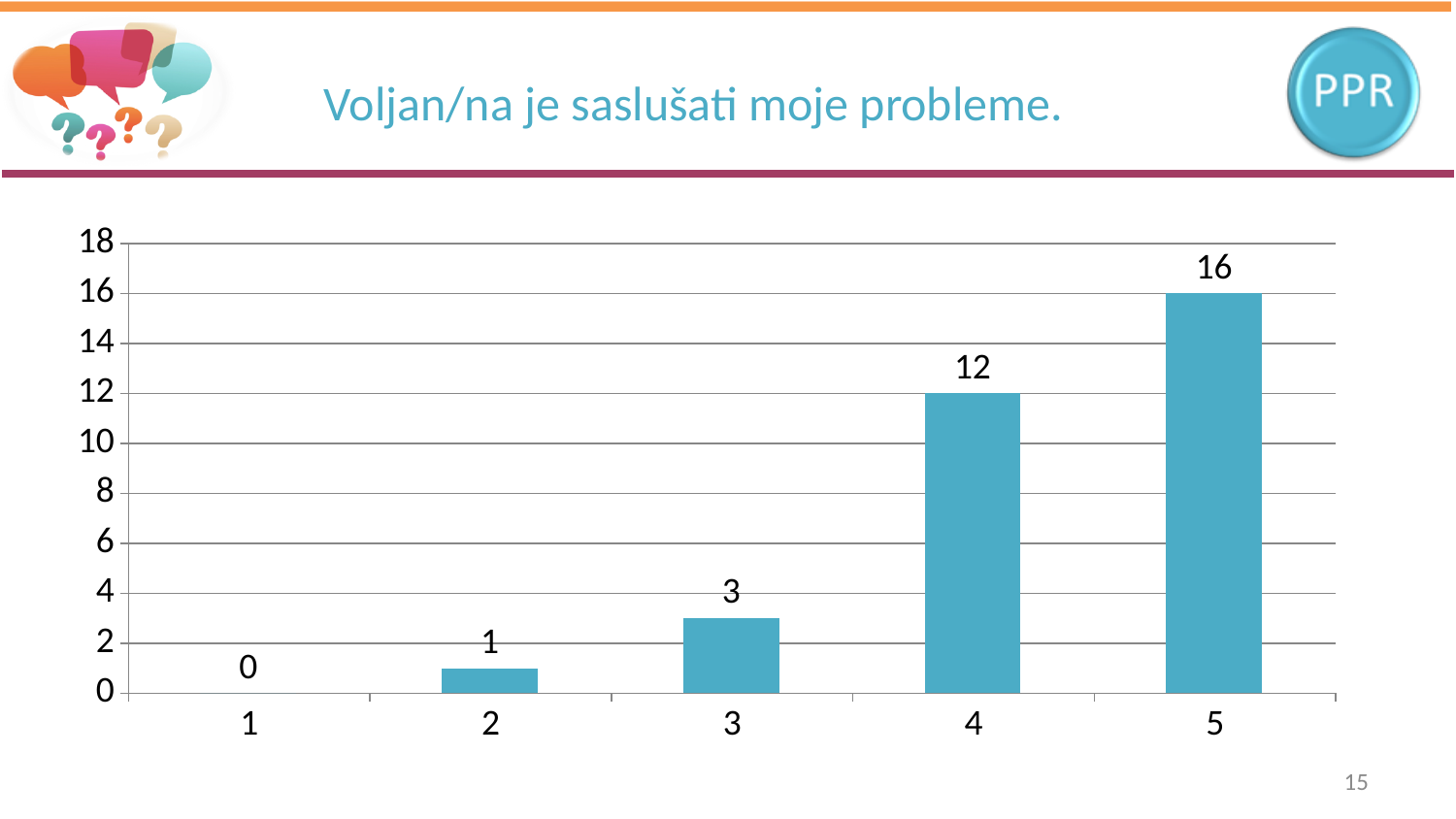
What is the title of the slide? Voljan/na je saslušati moje probleme. How many categories are shown on the x axis? 5 Which is larger, the value for category 3 or the value for category 2? category 3 What is the difference between the values for categories 5 and 4? 4 What is the value for category 1? 0 What is the value for category 2? 1 Is the value for category 5 greater or less than 14? greater What is the value for category 4? 12 Do the values rise or fall from category 1 to category 5? rise Which category has the highest value? 5 What kind of chart is shown on the slide? bar chart Which category has the lowest value? 1